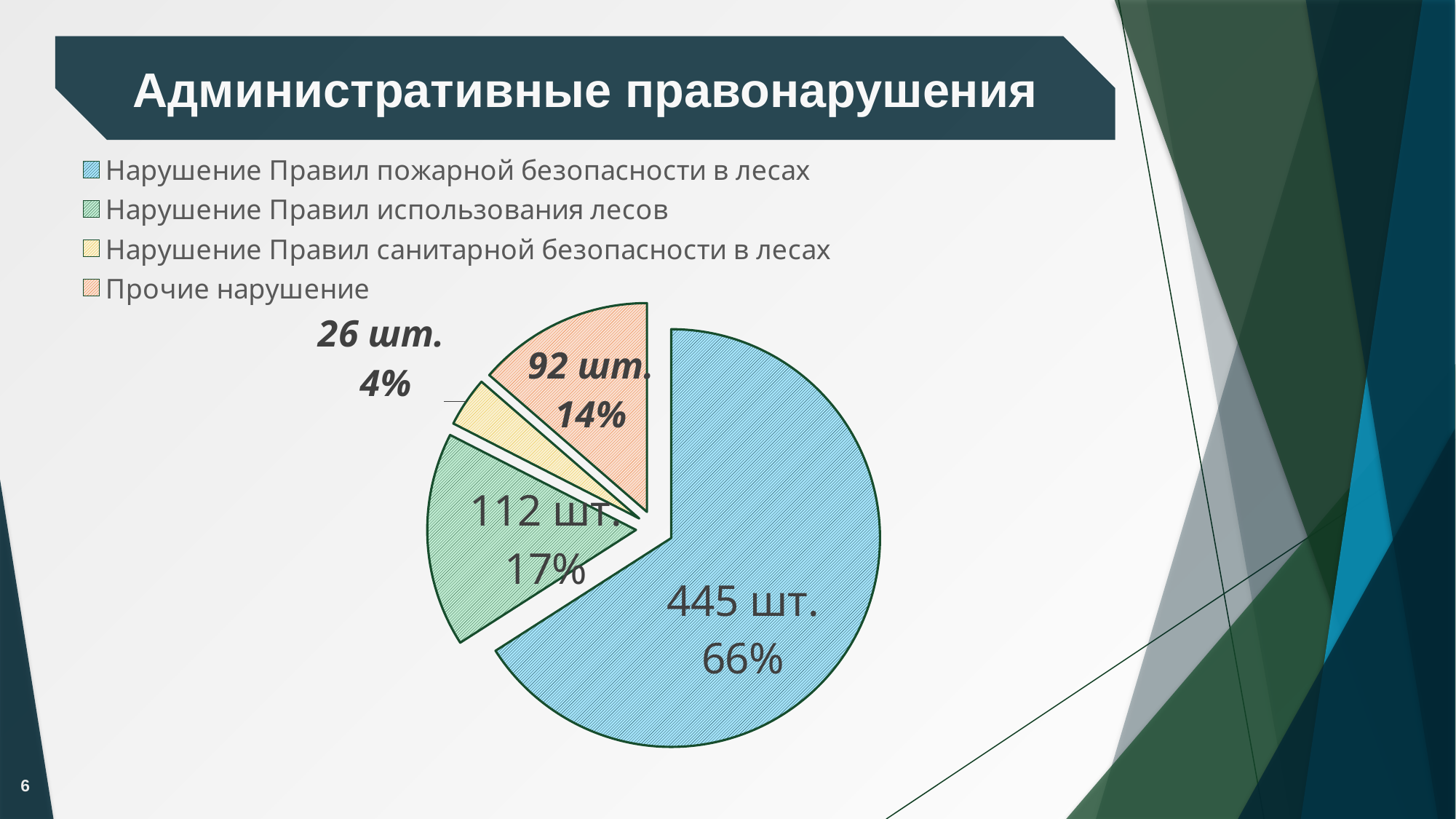
What is the value for 'Нарушение Правил пожарной безопасности в лесах'? 445 шт. What share of the pie does 'Нарушение Правил пожарной безопасности в лесах' take? 66% What is the difference between the values for 'Нарушение Правил пожарной безопасности в лесах' and 'Нарушение Правил использования лесов'? 333 шт. What share of the pie does 'Прочие нарушение' take? 14% What is the value for 'Нарушение Правил использования лесов'? 112 шт. Which is larger: the value for 'Нарушение Правил использования лесов' or for 'Прочие нарушение'? Нарушение Правил использования лесов Which category has the largest slice? Нарушение Правил пожарной безопасности в лесах Which category has the smallest slice? Нарушение Правил санитарной безопасности в лесах How many slices does the pie chart have? 4 How many entries does the legend list? 4 What kind of chart is shown on the slide? pie chart What is the value for 'Нарушение Правил санитарной безопасности в лесах'? 26 шт.